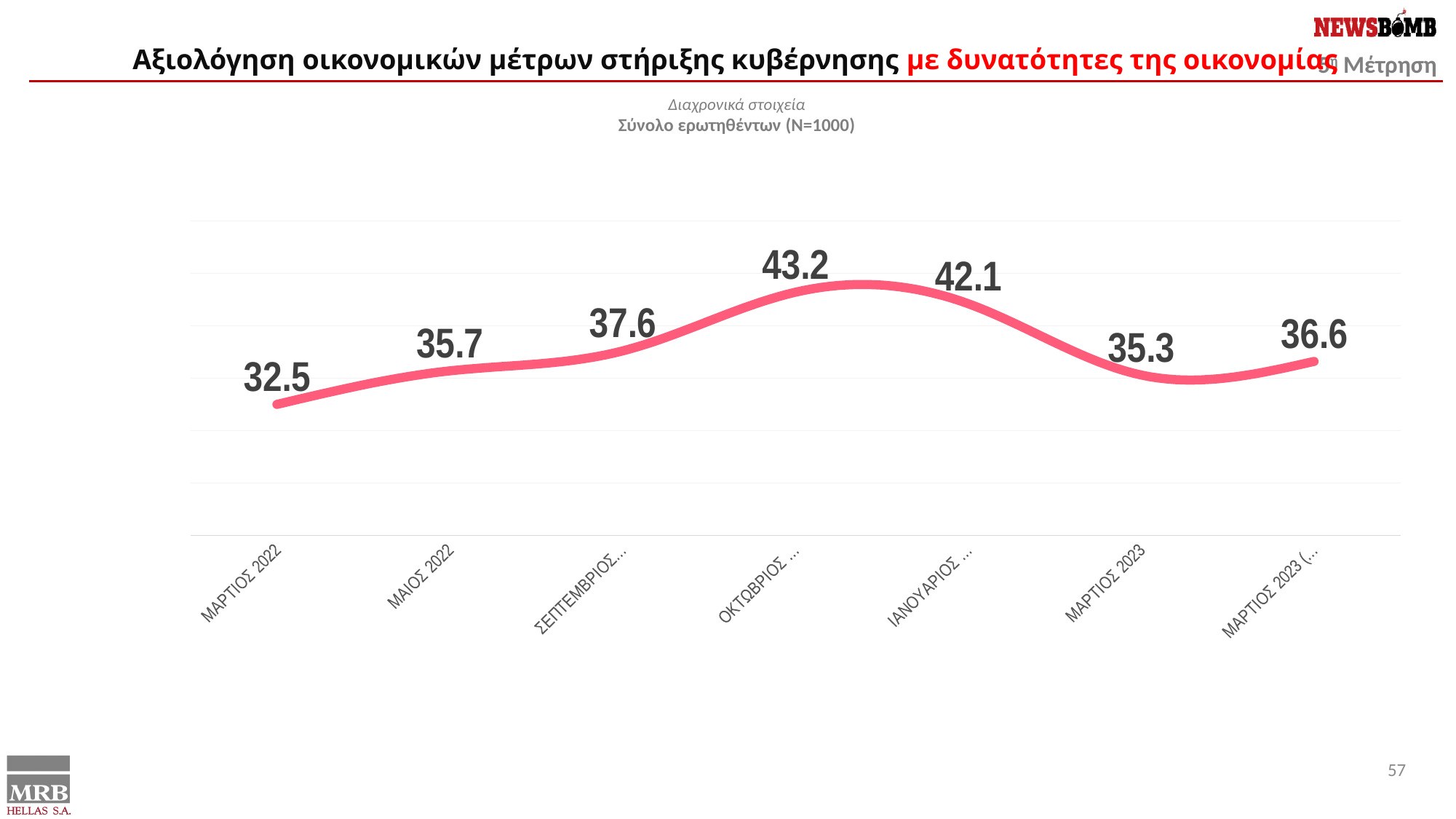
What is the value of the last (rightmost) point on the line? 36.6 What is the value for the ΙΑΝΟΥΑΡΙΟΣ point? 42.1 Which point on the line has the highest value? ΟΚΤΩΒΡΙΟΣ Does the line rise or fall between the ΙΑΝΟΥΑΡΙΟΣ point and the first ΜΑΡΤΙΟΣ 2023 point? Fall How many data points are plotted on the line? 7 What is the value for the ΟΚΤΩΒΡΙΟΣ point? 43.2 What is the value for ΜΑΡΤΙΟΣ 2022? 32.5 What is the value for ΜΑΙΟΣ 2022? 35.7 What kind of chart is shown on the slide? Line chart Which is larger, the value for ΜΑΙΟΣ 2022 or the value for the ΣΕΠΤΕΜΒΡΙΟΣ point? ΣΕΠΤΕΜΒΡΙΟΣ Which point on the line has the lowest value? ΜΑΡΤΙΟΣ 2022 What is the difference between the ΟΚΤΩΒΡΙΟΣ value and the ΜΑΡΤΙΟΣ 2022 value? 10.7